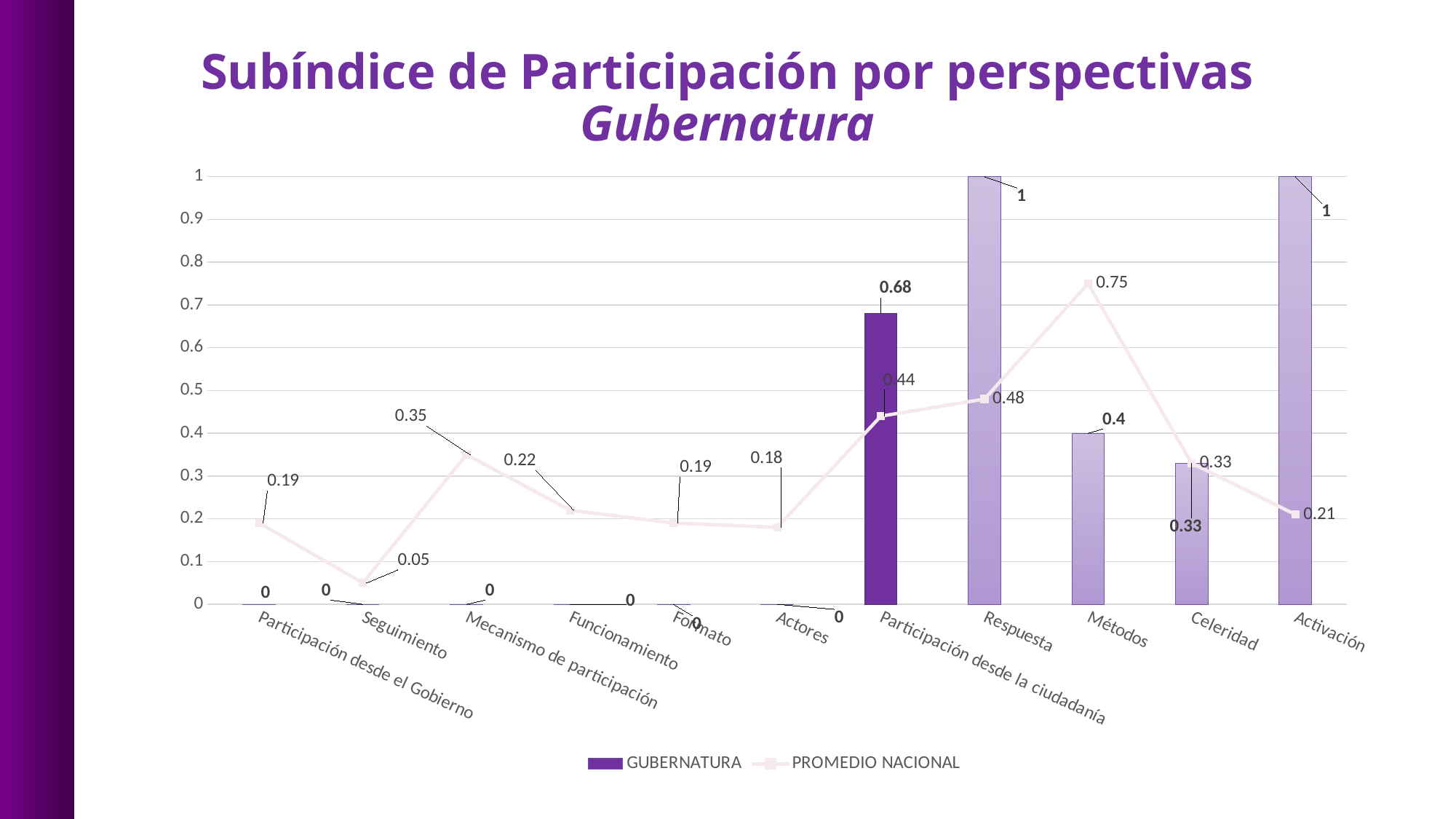
How many categories are shown on the x axis? 11 What is the PROMEDIO NACIONAL value for Métodos? 0.75 What kind of chart is shown on the slide? A bar chart combined with a line chart For Participación desde la ciudadanía, how much higher is the GUBERNATURA value than the PROMEDIO NACIONAL value? 0.24 Which category has the lowest PROMEDIO NACIONAL value? Seguimiento What is the GUBERNATURA value for Métodos? 0.4 What is the GUBERNATURA value for Participación desde la ciudadanía? 0.68 For Métodos, what is the difference between the PROMEDIO NACIONAL value and the GUBERNATURA value? 0.35 What is the PROMEDIO NACIONAL value for Activación? 0.21 How many series does the legend list? 2 For Respuesta, which series has the larger value, GUBERNATURA or PROMEDIO NACIONAL? GUBERNATURA Which category has the highest PROMEDIO NACIONAL value? Métodos